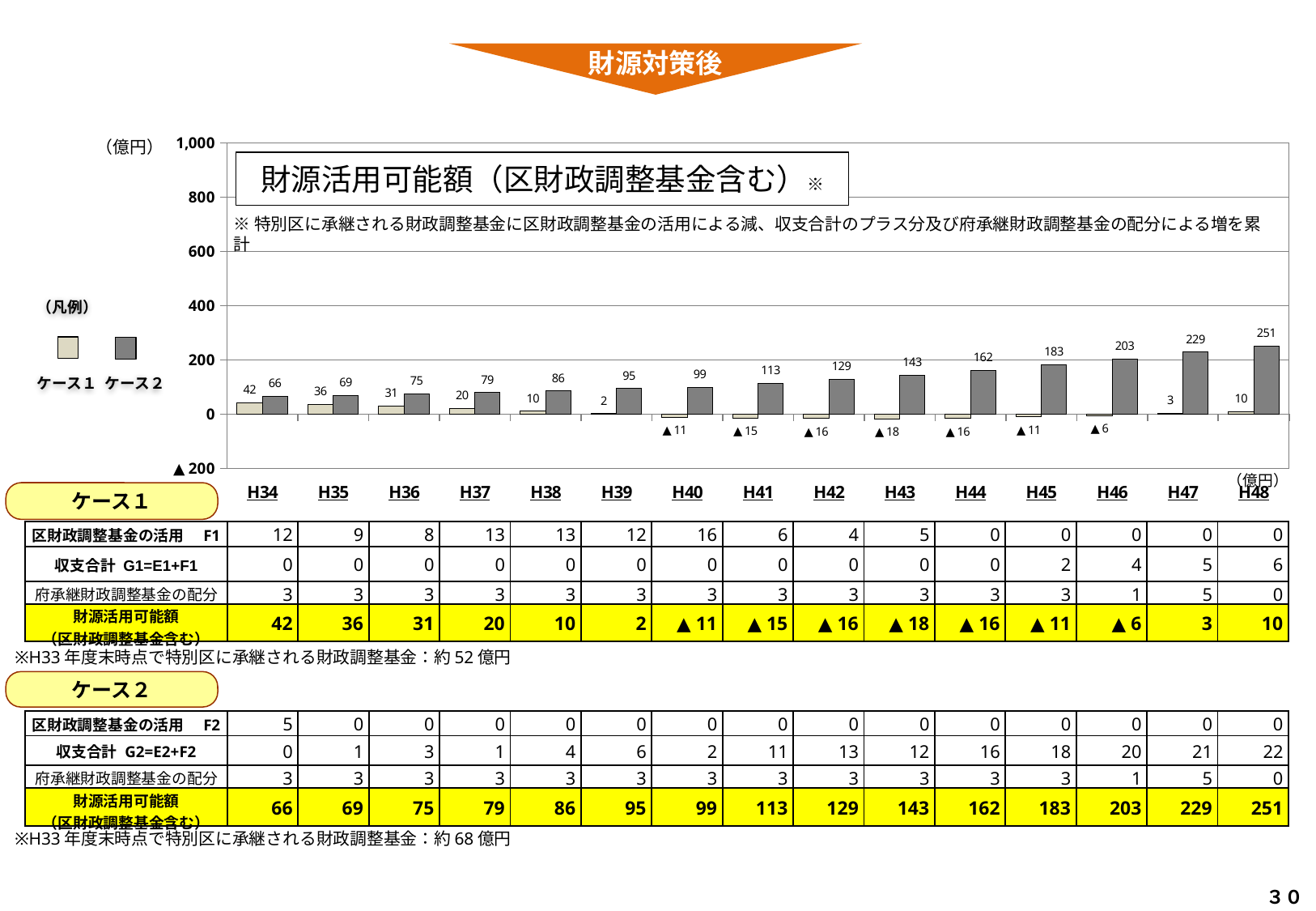
Which is larger in H46, ケース1 or ケース2? ケース2 What is the value for ケース2 in H41? 113 What is the value for ケース2 in H48? 251 What kind of chart is shown on the slide? bar chart What is the value for ケース1 in H43? ▲ 18 In which year is the value for ケース2 highest? H48 How many years are shown on the x axis of the chart? 15 Do the values for ケース2 rise or fall from H34 to H48? rise What is the value for ケース1 in H34? 42 What is the difference between ケース2 and ケース1 in H34? 24 In which year is the value for ケース1 lowest? H43 How many series does the legend list? 2